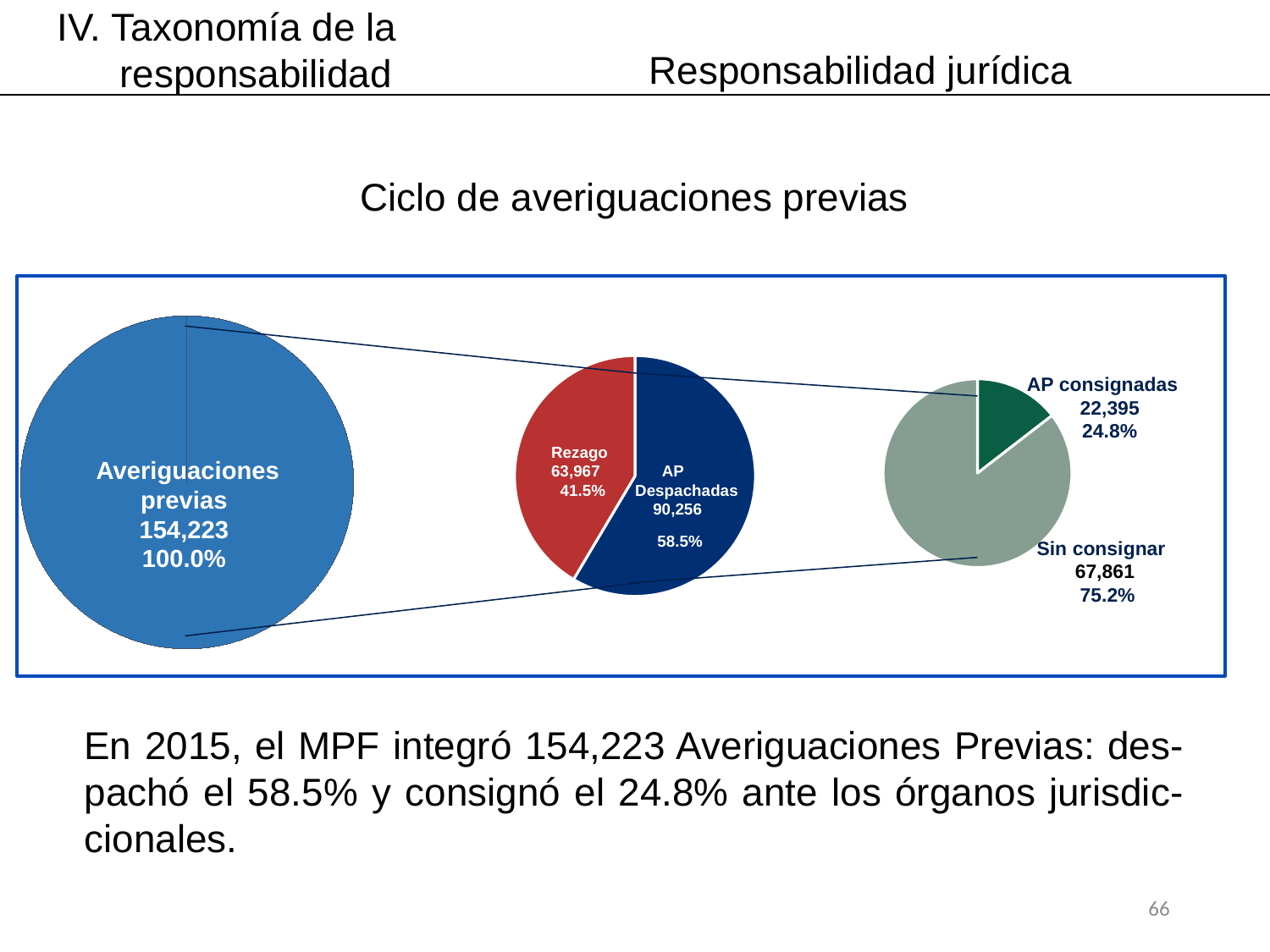
In the right-hand pie chart, which slice is the smallest? AP consignadas In the middle pie chart, which slice is larger, Rezago or AP Despachadas? AP Despachadas In the right-hand pie chart, what percentage is shown for Sin consignar? 75.2% In the right-hand pie chart, what share of the pie does AP consignadas represent? 24.8% In the right-hand pie chart, what is the value shown for AP consignadas? 22,395 What type of chart is the middle chart on the slide? Pie chart How many slices does the middle pie chart have? 2 In the middle pie chart, what is the value shown for Rezago? 63,967 In the left-hand circle, what value is shown for Averiguaciones previas? 154,223 In the right-hand pie chart, what is the difference between the Sin consignar value and the AP consignadas value? 45,466 In the middle pie chart, what is the difference between the AP Despachadas value and the Rezago value? 26,289 In the middle pie chart, what percentage is shown for AP Despachadas? 58.5%